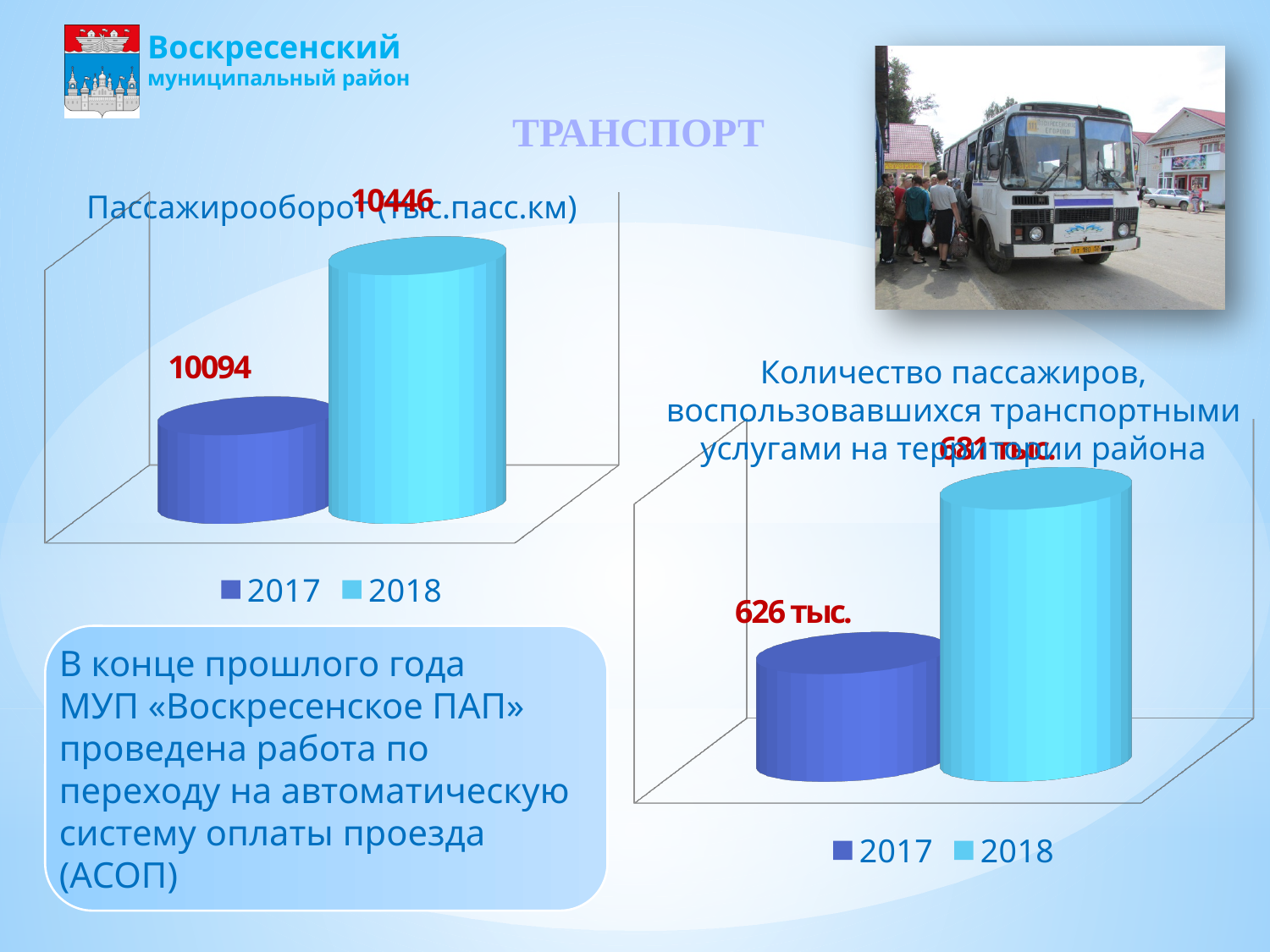
In the chart titled "Количество пассажиров, воспользовавшихся транспортными услугами на территории района", which legend entry is shown in light blue? 2018 In the chart titled "Количество пассажиров, воспользовавшихся транспортными услугами на территории района", do the values rise or fall from 2017 to 2018? rise In the chart titled "Пассажирооборот (тыс.пасс.км)", how many series does the legend list? 2 In the chart titled "Пассажирооборот (тыс.пасс.км)", what is the value for 2018? 10446 In the chart titled "Количество пассажиров, воспользовавшихся транспортными услугами на территории района", what is the value for 2018? 681 тыс. What kind of chart is the chart titled "Пассажирооборот (тыс.пасс.км)"? bar chart In the chart titled "Количество пассажиров, воспользовавшихся транспортными услугами на территории района", by how much does the 2018 value exceed the 2017 value? 55 тыс. In the chart titled "Количество пассажиров, воспользовавшихся транспортными услугами на территории района", what is the value for 2017? 626 тыс. In the chart titled "Пассажирооборот (тыс.пасс.км)", what is the value for 2017? 10094 In the chart titled "Пассажирооборот (тыс.пасс.км)", which year has the higher value? 2018 In the chart titled "Пассажирооборот (тыс.пасс.км)", what is the difference between the 2018 and 2017 values? 352 In the chart titled "Количество пассажиров, воспользовавшихся транспортными услугами на территории района", which year has the lower value? 2017